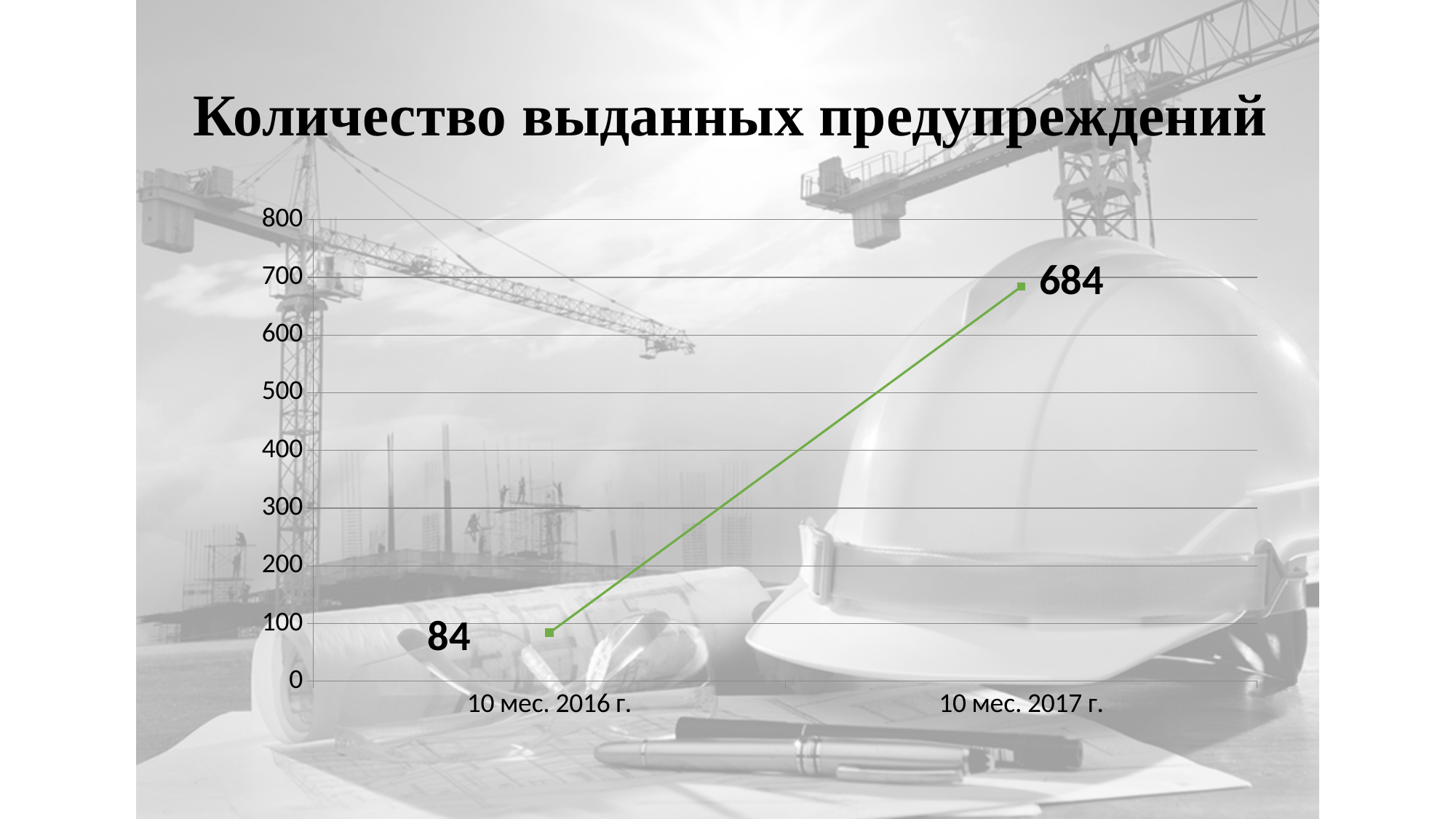
What is the title of the chart? Количество выданных предупреждений Which period has the lowest value? 10 мес. 2016 г. What is the value for 10 мес. 2017 г.? 684 What kind of chart is shown on the slide? line chart Which period has the highest value? 10 мес. 2017 г. Which is larger: the value for 10 мес. 2016 г. or for 10 мес. 2017 г.? 10 мес. 2017 г. What is the difference between the values for 10 мес. 2017 г. and 10 мес. 2016 г.? 600 Is the value for 10 мес. 2016 г. greater or less than 100? less Is the value for 10 мес. 2017 г. greater or less than 600? greater What is the value for 10 мес. 2016 г.? 84 Do the values rise or fall from 10 мес. 2016 г. to 10 мес. 2017 г.? rise How many data points are plotted on the chart? 2